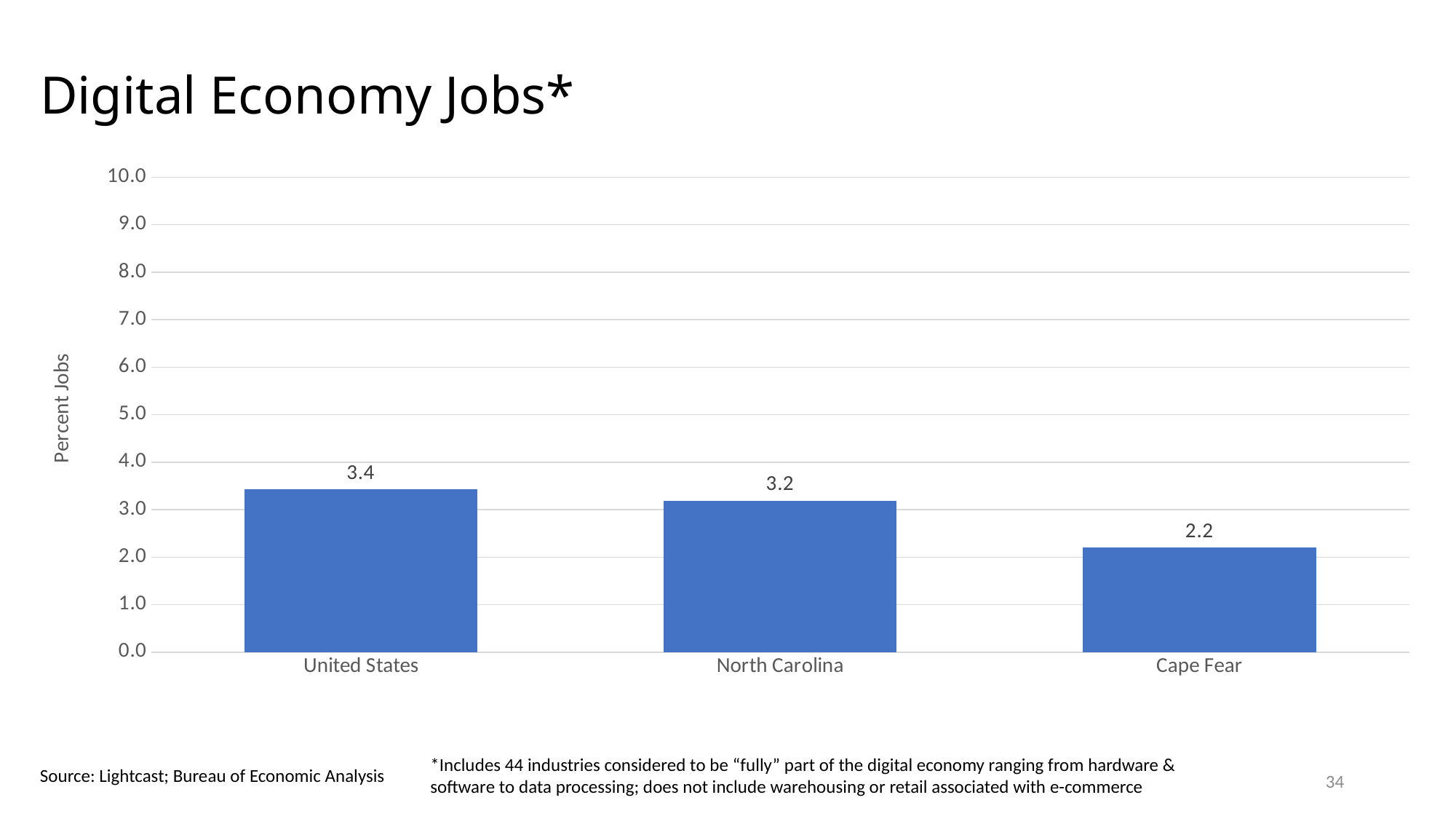
What is the label of the vertical axis? Percent Jobs What is the difference between the values for United States and Cape Fear? 1.2 How many categories are shown on the chart? 3 Which is larger, the value for North Carolina or the value for Cape Fear? North Carolina What is the difference between the values for North Carolina and Cape Fear? 1.0 What kind of chart is shown on the slide? bar chart Which category has the highest value? United States Is the value for Cape Fear greater or less than 3.0? less What is the value for United States? 3.4 What is the value for North Carolina? 3.2 Which category has the lowest value? Cape Fear What is the value for Cape Fear? 2.2